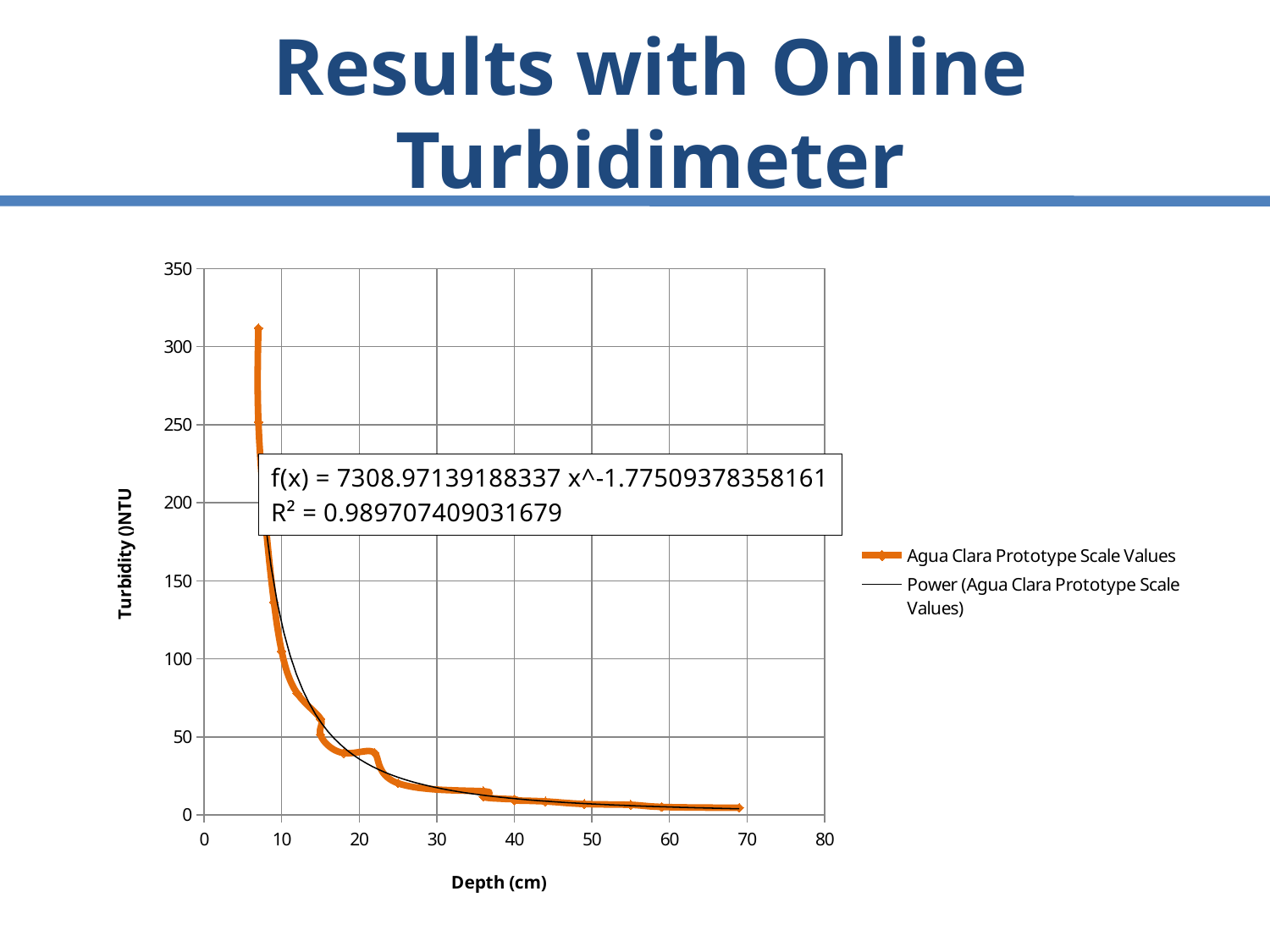
Do the turbidity values rise or fall as depth increases along the x axis? fall What is the maximum value shown on the x axis? 80 What is the maximum value shown on the y axis? 350 Is the highest plotted turbidity value greater or less than 250? greater What is the R² value shown for the trendline? 0.989707409031679 How many series does the legend list? 2 Is the turbidity value at a depth of 60 cm greater or less than 50? less Is the turbidity value at a depth of 30 cm greater or less than 50? less What type of chart is shown on the slide? line chart What is the label of the x axis? Depth (cm)